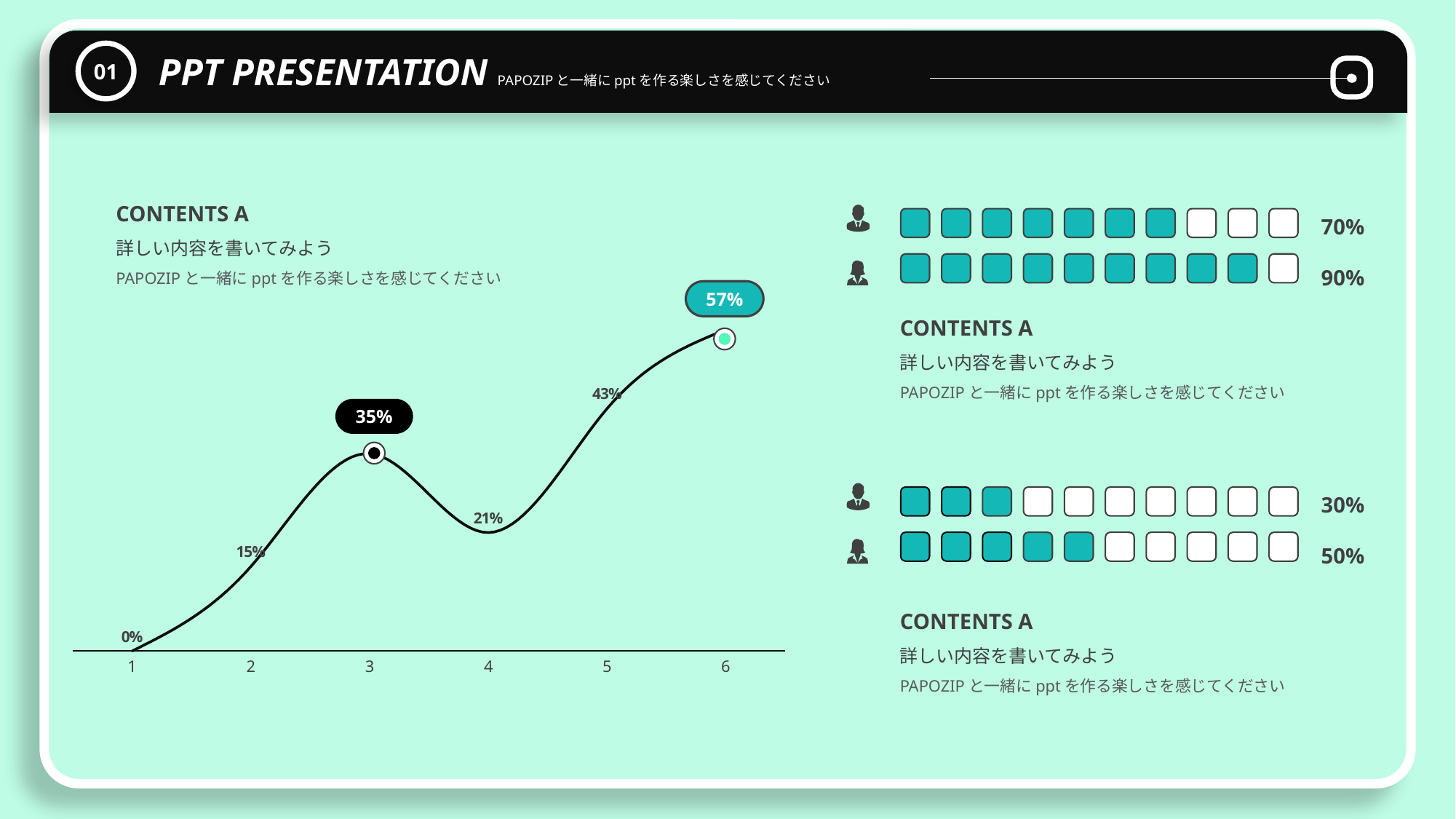
On the line chart, what is the difference between the values at x = 6 and x = 3? 22% On the line chart, what is the value at x = 3? 35% On the line chart, what is the value at x = 4? 21% On the line chart, what is the difference between the values at x = 5 and x = 4? 22% On the line chart, what is the value at x = 2? 15% On the line chart, what is the value at x = 6? 57% On the line chart, at which x value is the plotted value lowest? 1 On the line chart, at which x value is the plotted value highest? 6 On the line chart, what is the value at x = 5? 43% On the line chart, which has the larger value, x = 3 or x = 4? 3 What kind of chart is shown on the left of the slide? Line chart How many data points are plotted on the line chart? 6